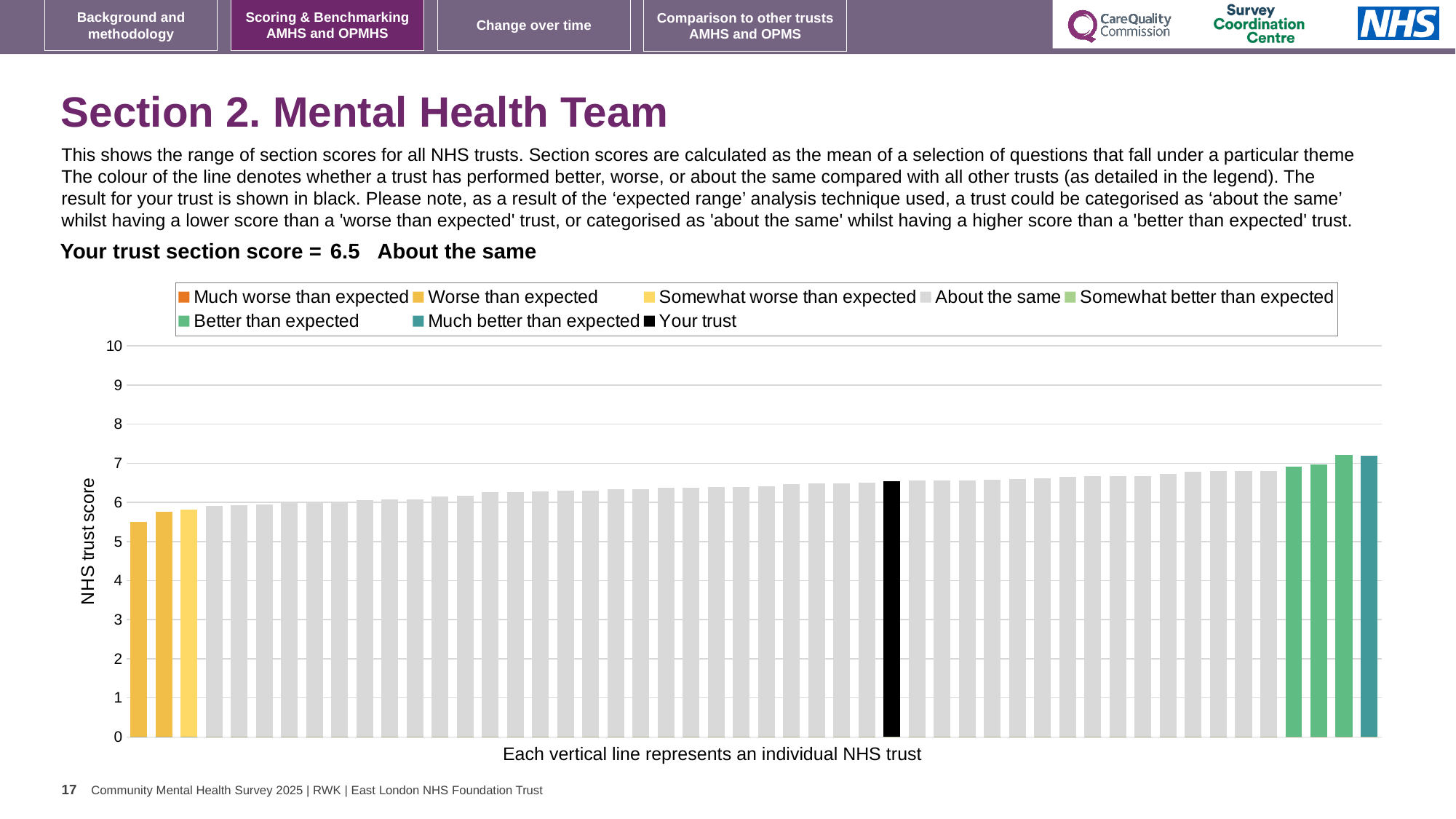
What colour is the bar representing your trust? black Is the value for the leftmost bar greater or less than 6? less What is the label on the vertical axis of the chart? NHS trust score Do the bar values rise or fall from left to right along the x axis? rise How many entries does the chart legend list? 8 Is the value for the rightmost bar greater or less than 6? greater What kind of chart is shown on the slide? bar chart Is the value for your trust (the black bar) greater or less than 6? greater Which is larger: the value for your trust (the black bar) or the value for the leftmost bar? your trust What is the section score for your trust shown on the slide? 6.5 Which category is your trust's section score placed in, according to the text above the chart? About the same